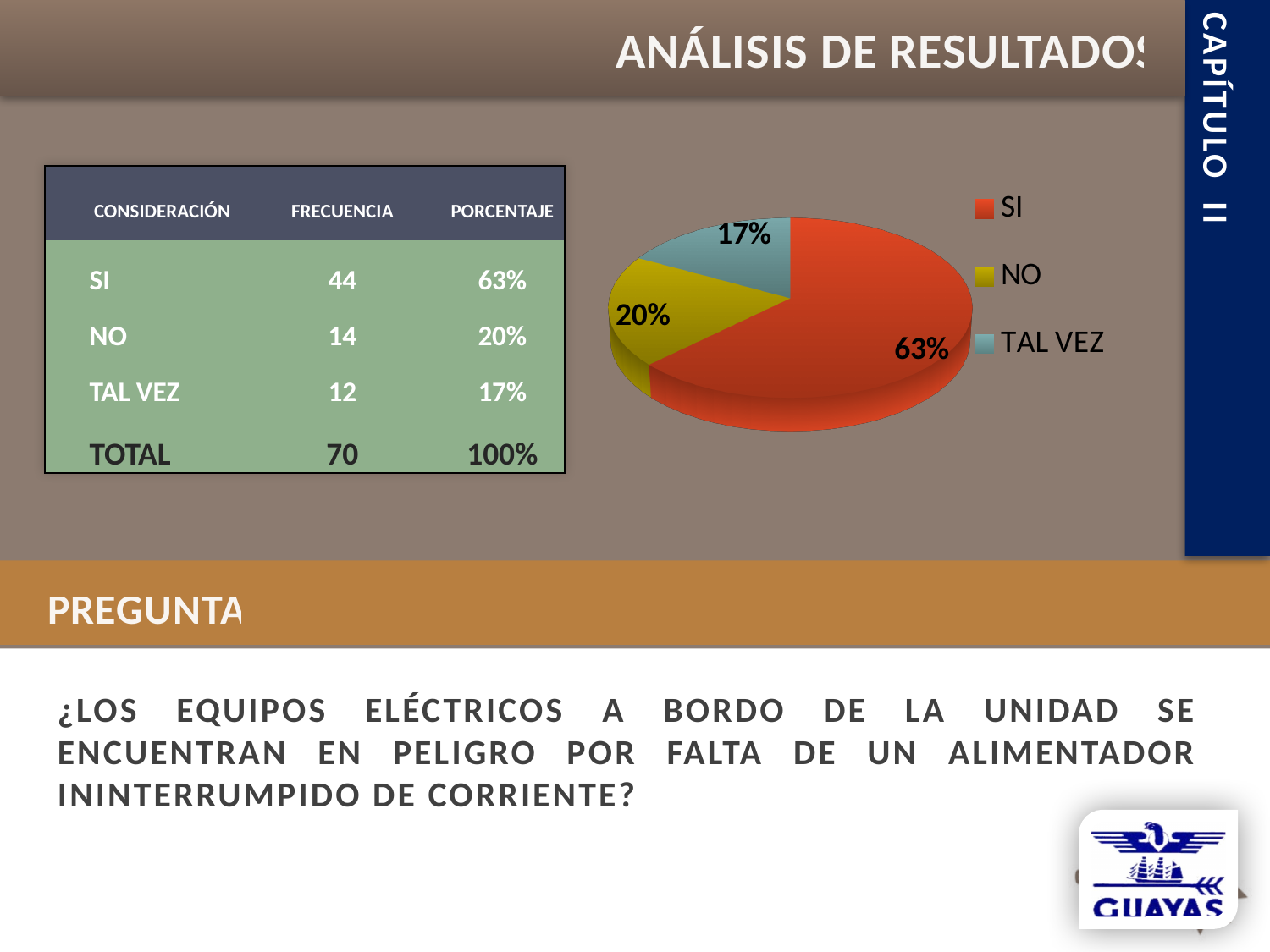
What percentage does the SI slice of the pie chart show? 63% How many slices does the pie chart have? 3 What percentage does the TAL VEZ slice of the pie chart show? 17% Which slice is larger in the pie chart, NO or TAL VEZ? NO What percentage does the NO slice of the pie chart show? 20% What colour is the SI slice in the pie chart? Red Which category has the largest slice in the pie chart? SI What kind of chart is shown on the slide? Pie chart What is the difference in percentage points between the SI slice and the NO slice? 43 How many entries does the legend of the pie chart list? 3 What colour is the NO slice in the pie chart? Yellow Which category has the smallest slice in the pie chart? TAL VEZ